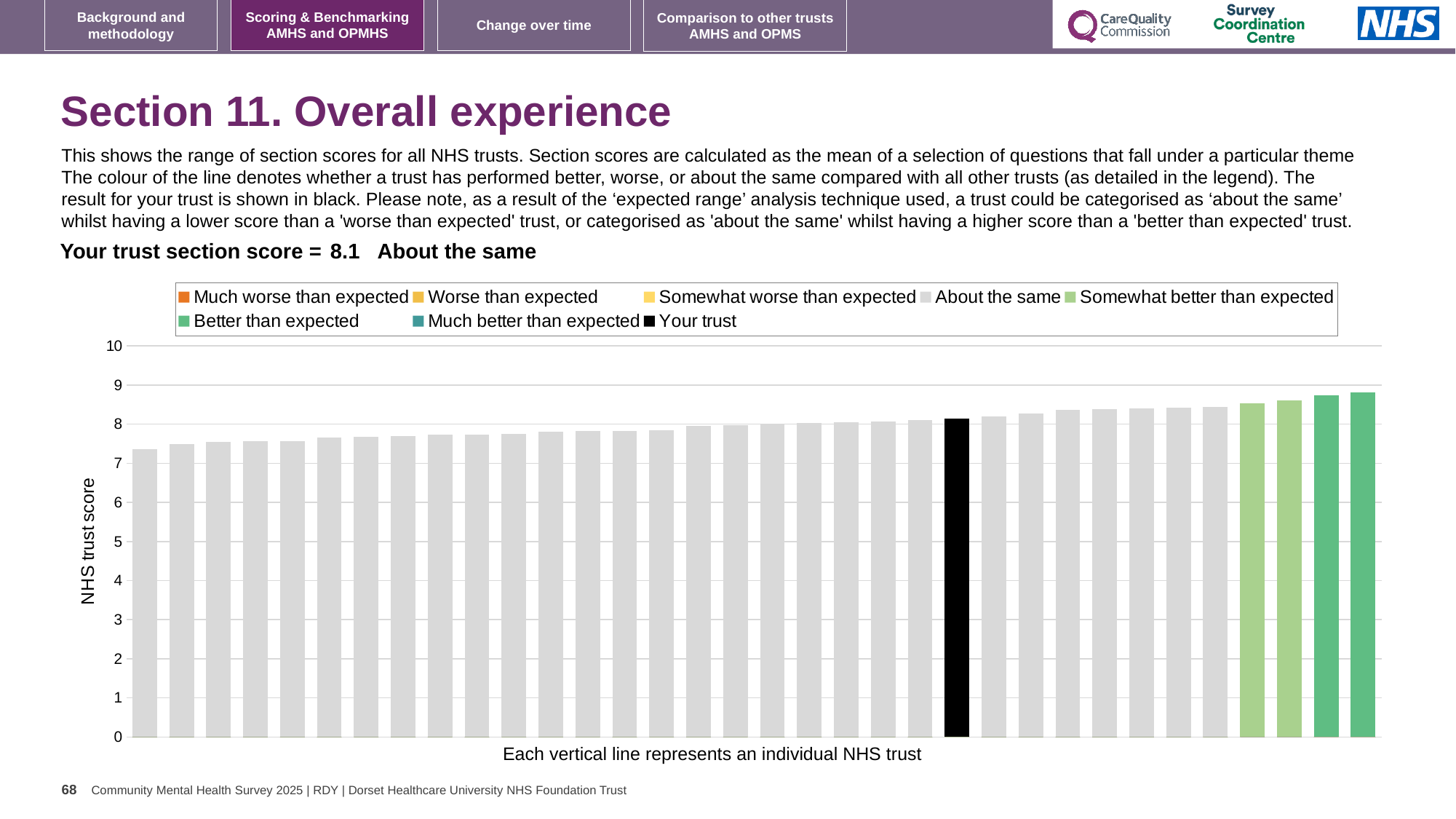
Do the bar values rise or fall from left to right along the x axis? rise How many bars are coloured as 'Somewhat better than expected' (light green)? 2 Is the value of the rightmost bar greater or less than 8? greater How many entries does the chart legend list? 8 Is the value of the leftmost bar greater or less than 8? less Which category is your trust placed in for this section? About the same What is the section score for your trust shown on the slide? 8.1 Which bar is the highest in the chart: the leftmost bar or the rightmost bar? rightmost bar What is the label on the vertical axis of the chart? NHS trust score What colour is the bar representing your trust? black Is the value for your trust (the black bar) greater or less than 8? greater What kind of chart is shown on the slide? bar chart